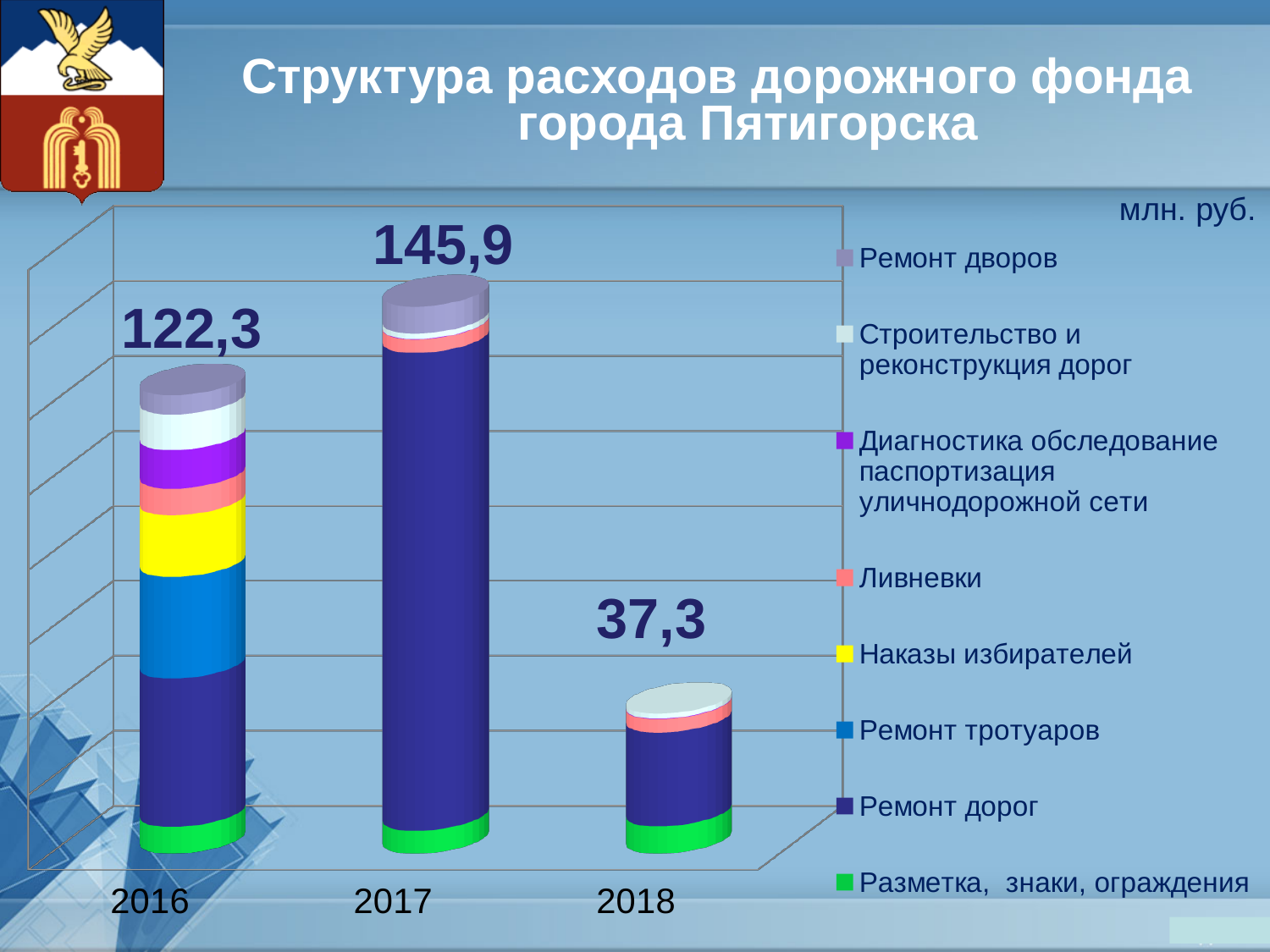
What is the difference between the totals for 2017 and 2018? 108,6 How many years are shown on the x axis? 3 In what units are the values on the chart expressed? млн. руб. What is the total value shown for 2017? 145,9 What kind of chart is shown on the slide? Stacked bar chart Which year has the highest total expenditure? 2017 Which year has the lowest total expenditure? 2018 What is the difference between the totals for 2017 and 2016? 23,6 Which is larger, the total for 2016 or the total for 2018? 2016 What is the total value shown for 2016? 122,3 What is the total value shown for 2018? 37,3 How many series does the legend list? 8